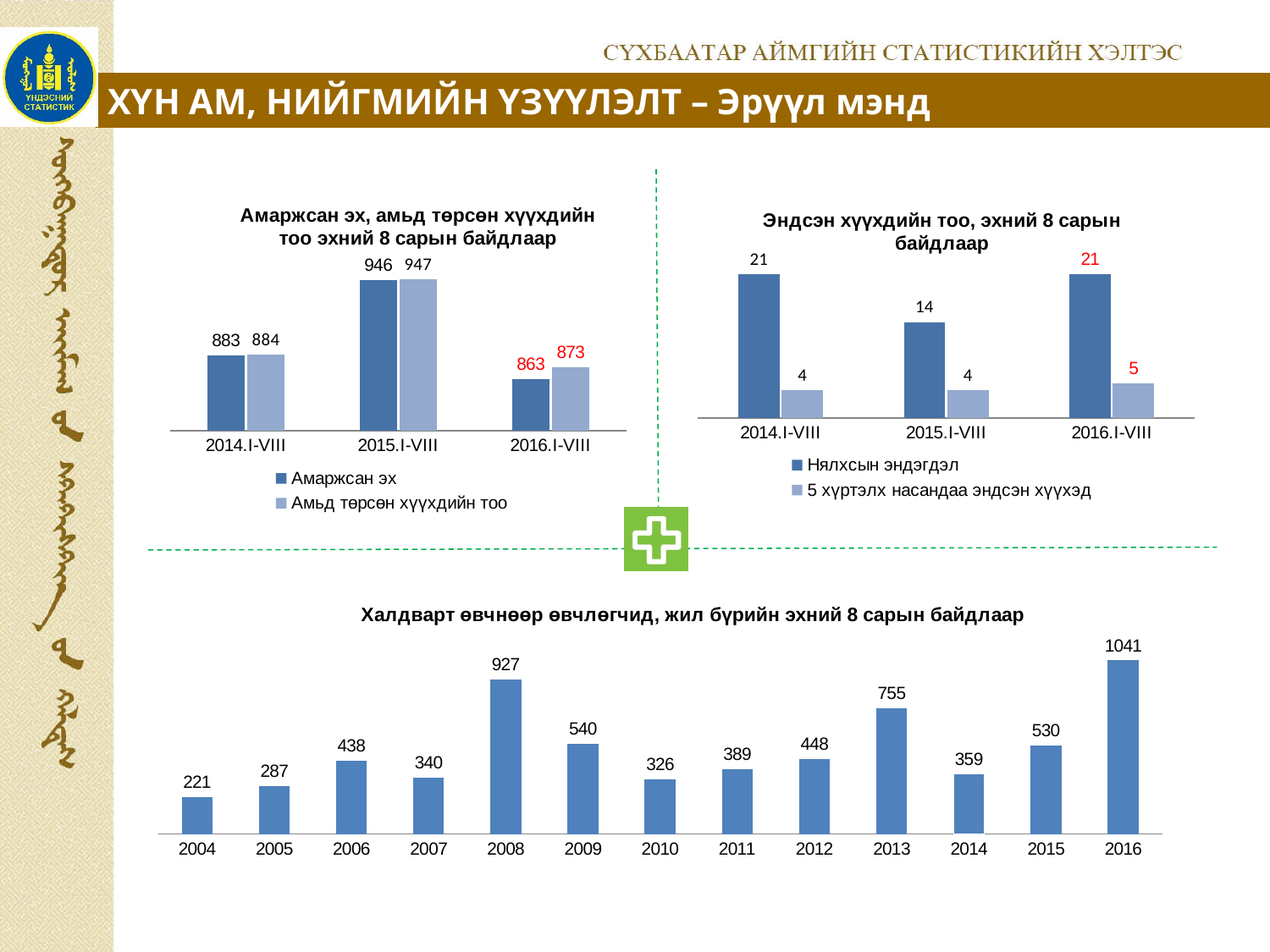
In the top-right chart (Эндсэн хүүхдийн тоо), which period has the lowest value for Нялхсын эндэгдэл? 2015.I-VIII In the bottom chart (Халдварт өвчнөөр өвчлөгчид), which year has the highest value? 2016 In the top-left chart (Амаржсан эх, амьд төрсөн хүүхдийн тоо), what is the value for Амаржсан эх in 2015.I-VIII? 946 In the bottom chart (Халдварт өвчнөөр өвчлөгчид), what is the value for 2013? 755 In the bottom chart (Халдварт өвчнөөр өвчлөгчид), which year has the lowest value? 2004 In the bottom chart (Халдварт өвчнөөр өвчлөгчид), what is the difference between the values for 2016 and 2015? 511 In the top-right chart (Эндсэн хүүхдийн тоо), what is the value for Нялхсын эндэгдэл in 2015.I-VIII? 14 In the bottom chart (Халдварт өвчнөөр өвчлөгчид), how many years are shown on the x axis? 13 In the top-left chart (Амаржсан эх, амьд төрсөн хүүхдийн тоо), what is the value for Амьд төрсөн хүүхдийн тоо in 2016.I-VIII? 873 In the top-left chart (Амаржсан эх, амьд төрсөн хүүхдийн тоо), how many series does the legend list? 2 In the top-right chart (Эндсэн хүүхдийн тоо), what is the value for 5 хүртэлх насандаа эндсэн хүүхэд in 2016.I-VIII? 5 In the top-left chart (Амаржсан эх, амьд төрсөн хүүхдийн тоо), what is the difference between Амьд төрсөн хүүхдийн тоо and Амаржсан эх in 2016.I-VIII? 10